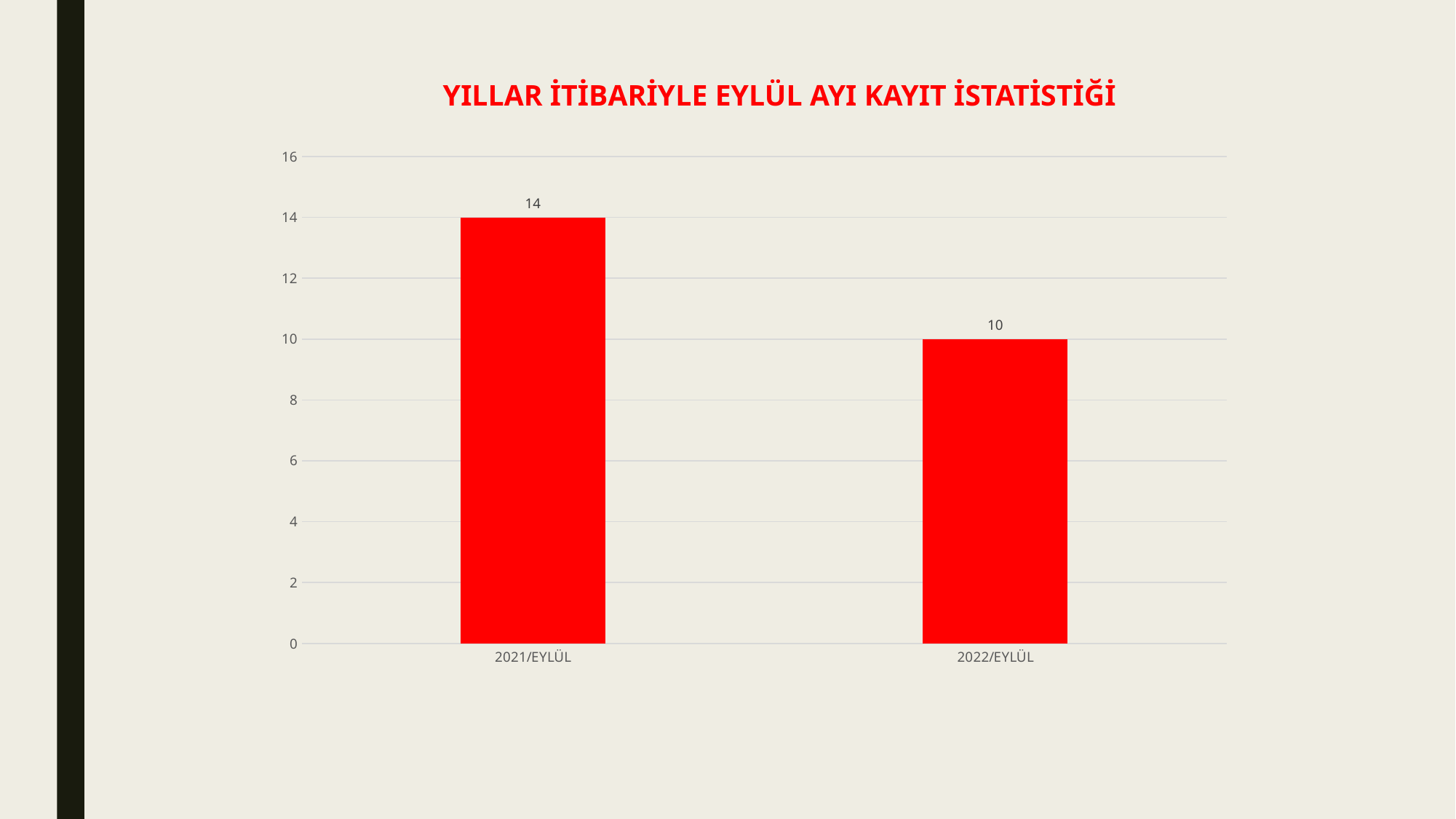
Which category has the highest value? 2021/EYLÜL What is the value for 2021/EYLÜL? 14 Which is larger, the value for 2021/EYLÜL or the value for 2022/EYLÜL? 2021/EYLÜL What kind of chart is shown on the slide? bar chart Is the value for 2022/EYLÜL greater or less than 12? less Which category has the lowest value? 2022/EYLÜL What is the value for 2022/EYLÜL? 10 Is the value for 2021/EYLÜL greater or less than 12? greater How many categories are shown on the x axis? 2 What is the title of the chart? YILLAR İTİBARİYLE EYLÜL AYI KAYIT İSTATİSTİĞİ What is the difference between the values for 2021/EYLÜL and 2022/EYLÜL? 4 Do the values rise or fall from 2021/EYLÜL to 2022/EYLÜL? fall